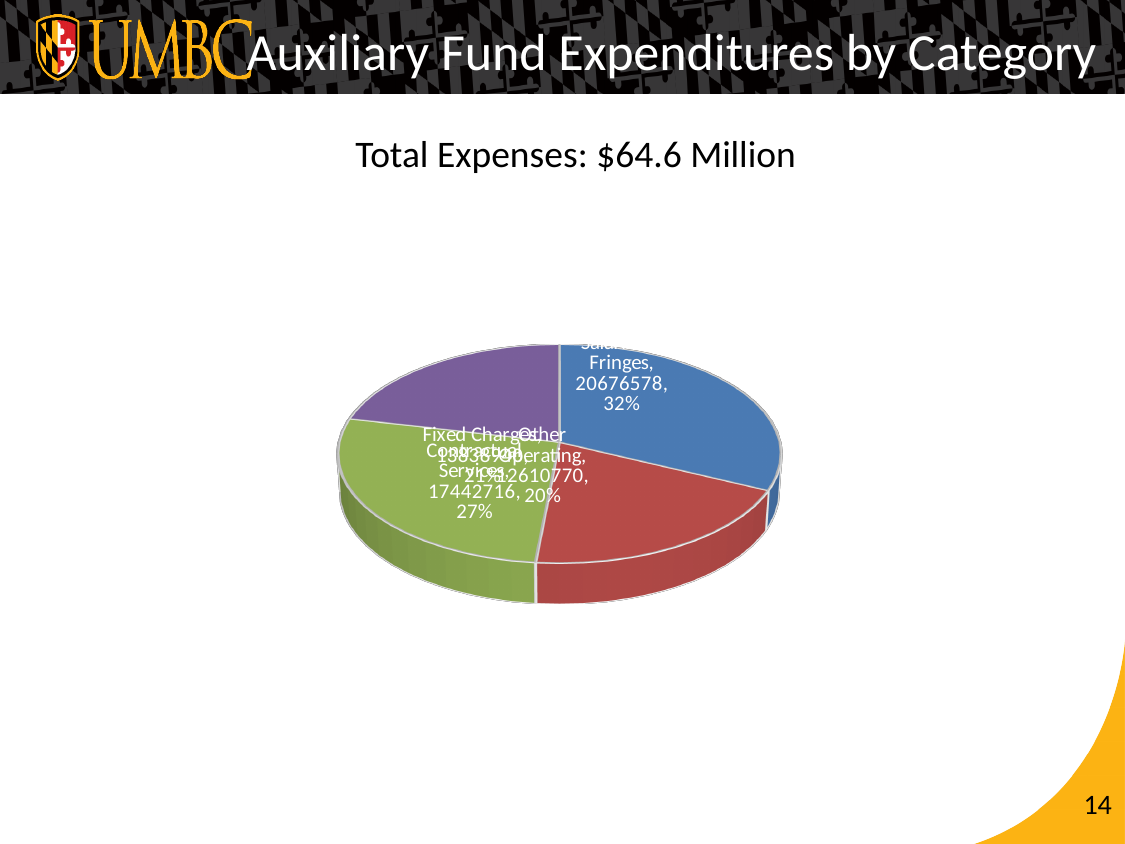
What total expenses figure is stated above the chart? $64.6 Million What kind of chart is shown on the slide? pie chart How many slices does the pie chart have? 4 Which is larger, the share for Contractual Services or the share for Other Operating? Contractual Services What is the value shown for Other Operating? 12610770 What share of expenditures is Salaries & Fringes? 32% What is the value shown for Contractual Services? 17442716 Which category has the largest share of expenditures? Salaries & Fringes What share of expenditures is Contractual Services? 27% What share of expenditures is Other Operating? 20% What is the value shown for Salaries & Fringes? 20676578 What is the difference in percentage points between the Salaries & Fringes share and the Contractual Services share? 5%